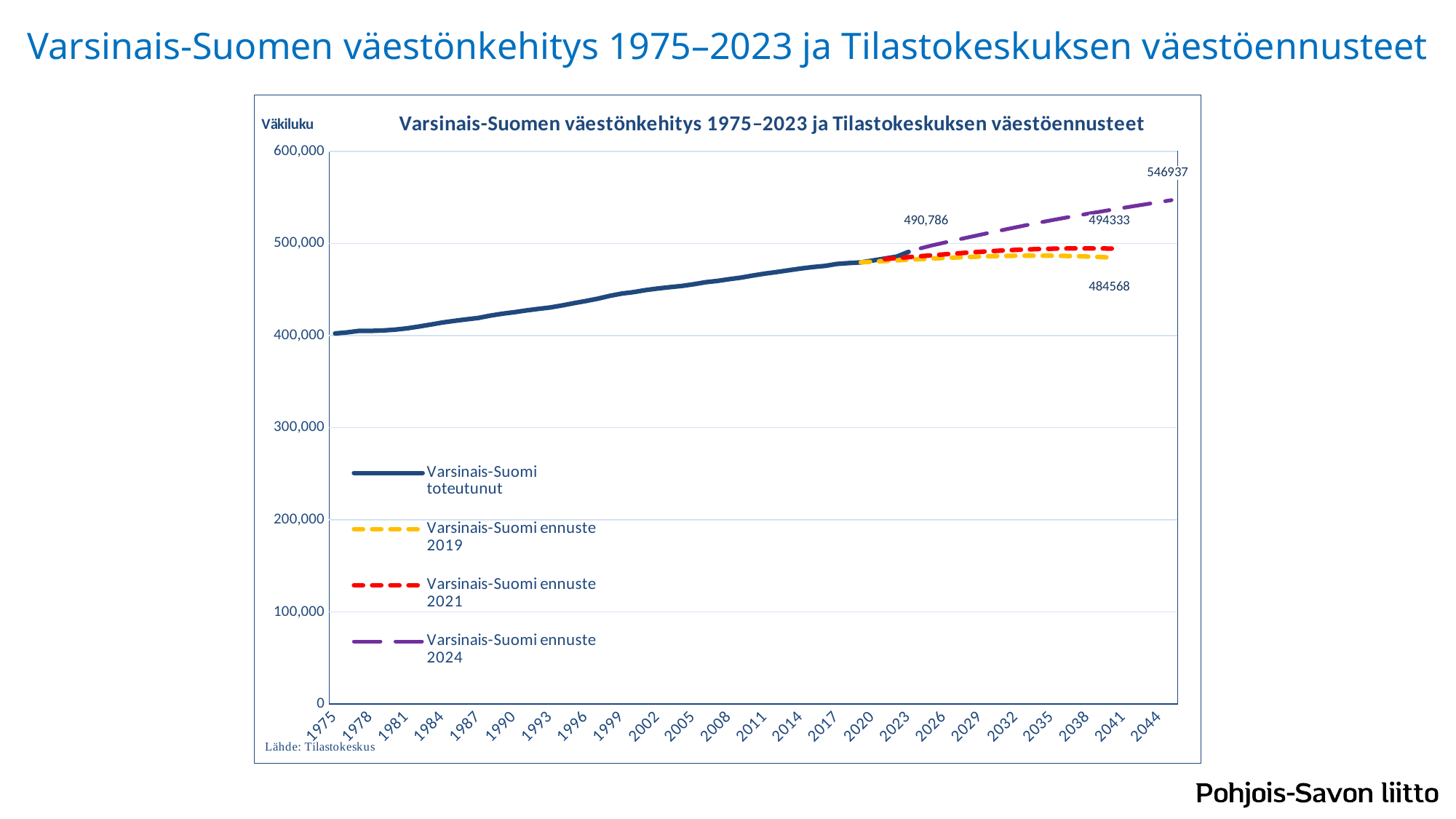
What is the final labelled value of the Varsinais-Suomi ennuste 2019 series? 484568 What is the final labelled value of the Varsinais-Suomi ennuste 2024 series? 546937 Which is larger: the end value of the 2021 forecast or the end value of the 2019 forecast? Varsinais-Suomi ennuste 2021 How many series does the legend list? 4 What is the difference between the end values of the 2024 forecast (546937) and the 2021 forecast (494333)? 52604 What kind of chart is shown on the slide? line chart Does the Varsinais-Suomi toteutunut series rise or fall from 1975 to 2023? rise Is the value of the Varsinais-Suomi toteutunut series in 1975 greater or less than 500,000? less Which forecast series ends at the highest value? Varsinais-Suomi ennuste 2024 Which forecast series ends at the lowest value? Varsinais-Suomi ennuste 2019 What is the final labelled value of the Varsinais-Suomi ennuste 2021 series? 494333 What is the final labelled value of the Varsinais-Suomi toteutunut series? 490,786